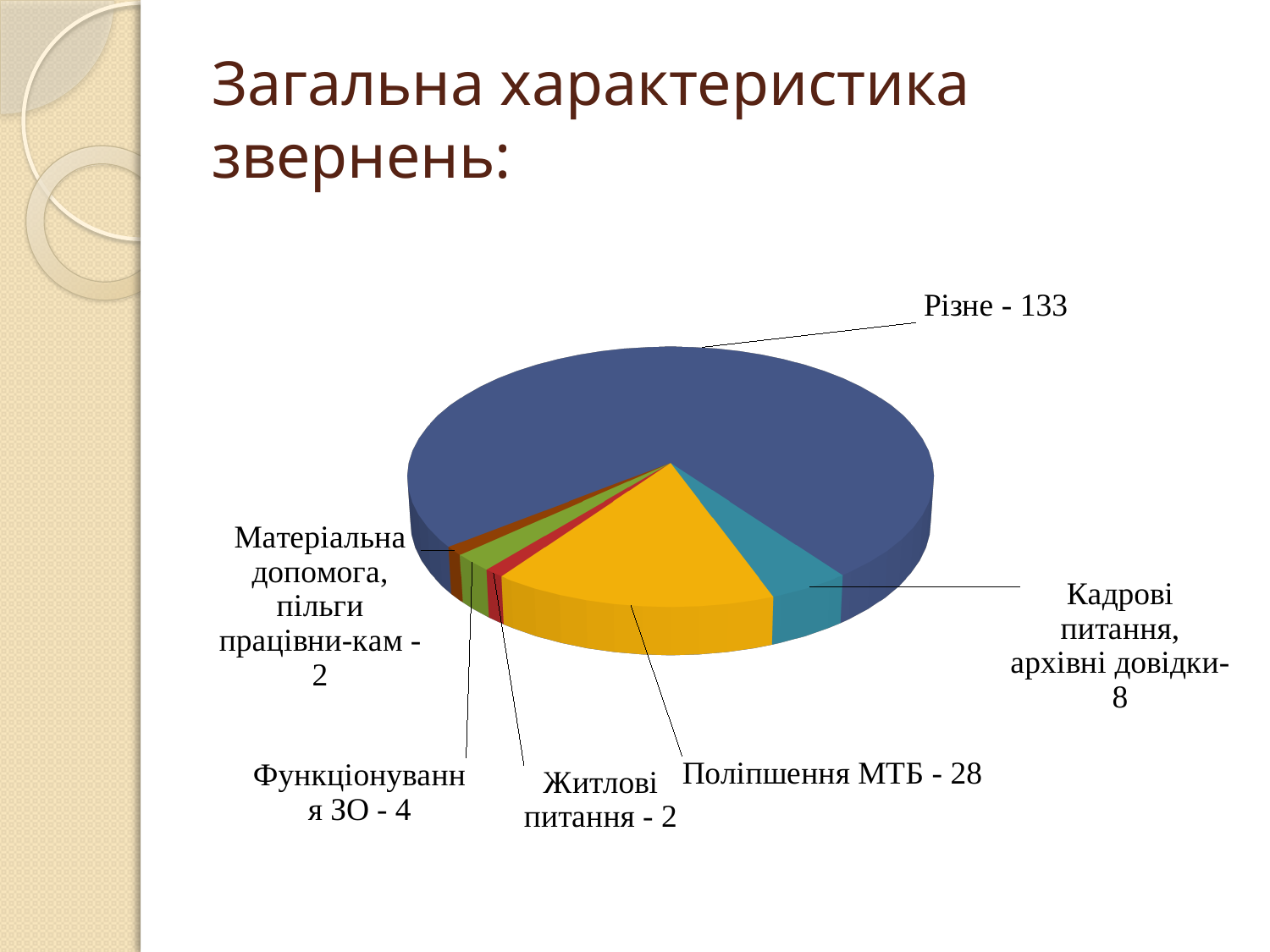
How many slices does the pie chart have? 6 What is the value for Кадрові питання, архівні довідки? 8 What is the value for Житлові питання? 2 What is the value for Поліпшення МТБ? 28 What is the difference between the values for Різне and Поліпшення МТБ? 105 Which is larger: the value for Поліпшення МТБ or the value for Кадрові питання, архівні довідки? Поліпшення МТБ What is the title of the slide containing the chart? Загальна характеристика звернень: What kind of chart is shown on the slide? pie chart Which category has the largest slice of the pie? Різне What is the value for Різне? 133 What is the value for Функціонування ЗО? 4 What is the difference between the values for Поліпшення МТБ and Кадрові питання, архівні довідки? 20